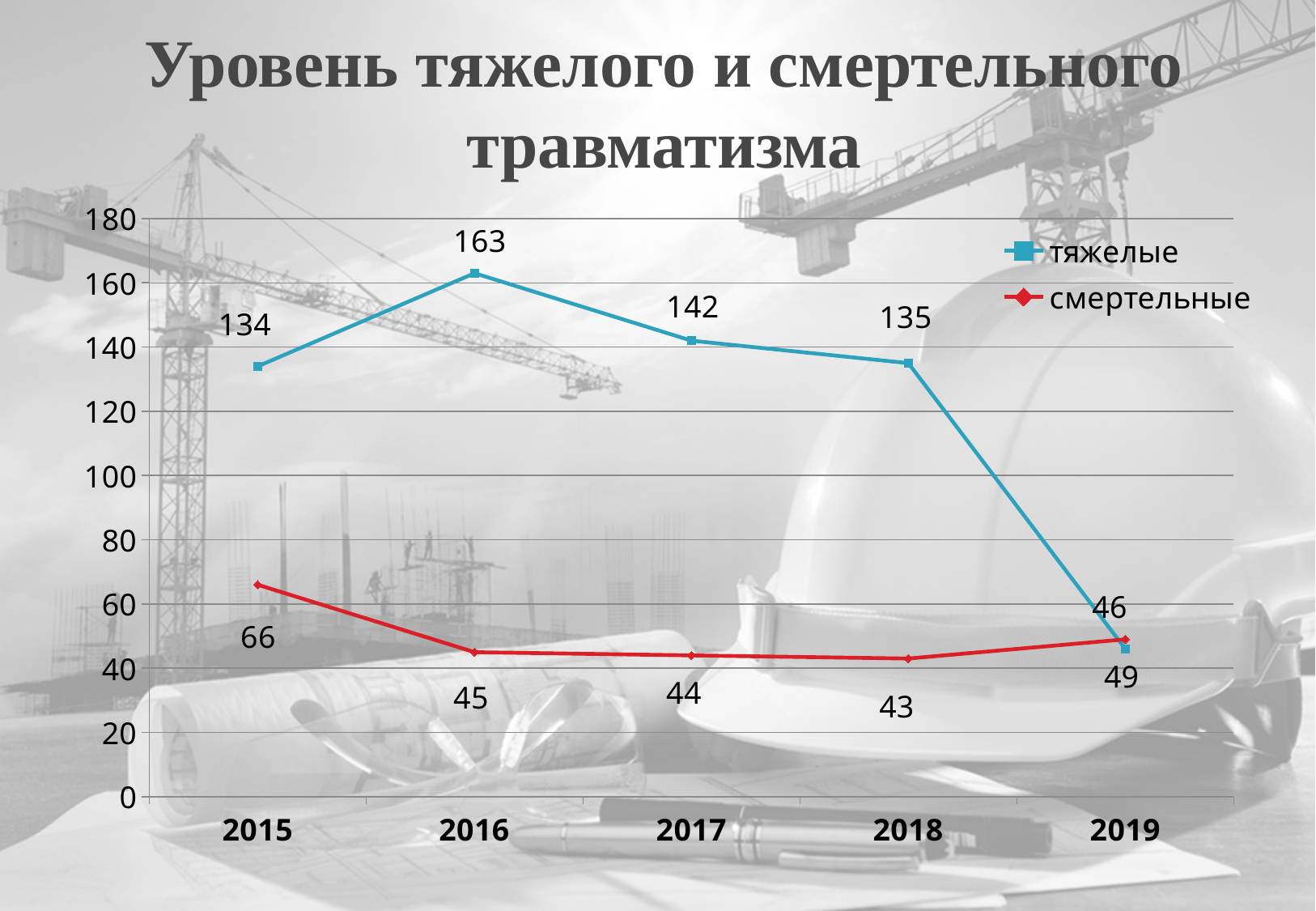
In which year is the тяжелые series highest? 2016 Which is larger in 2017: the тяжелые value or the смертельные value? тяжелые What type of chart is shown on the slide? line chart In which year is the смертельные series lowest? 2018 How many years are shown on the x axis? 5 What is the value of the смертельные series in 2018? 43 What is the value of the тяжелые series in 2019? 46 How many series does the legend list? 2 What is the difference between the тяжелые values in 2018 and 2019? 89 What is the title of the chart? Уровень тяжелого и смертельного травматизма What is the value of the тяжелые series in 2016? 163 What is the value of the смертельные series in 2015? 66